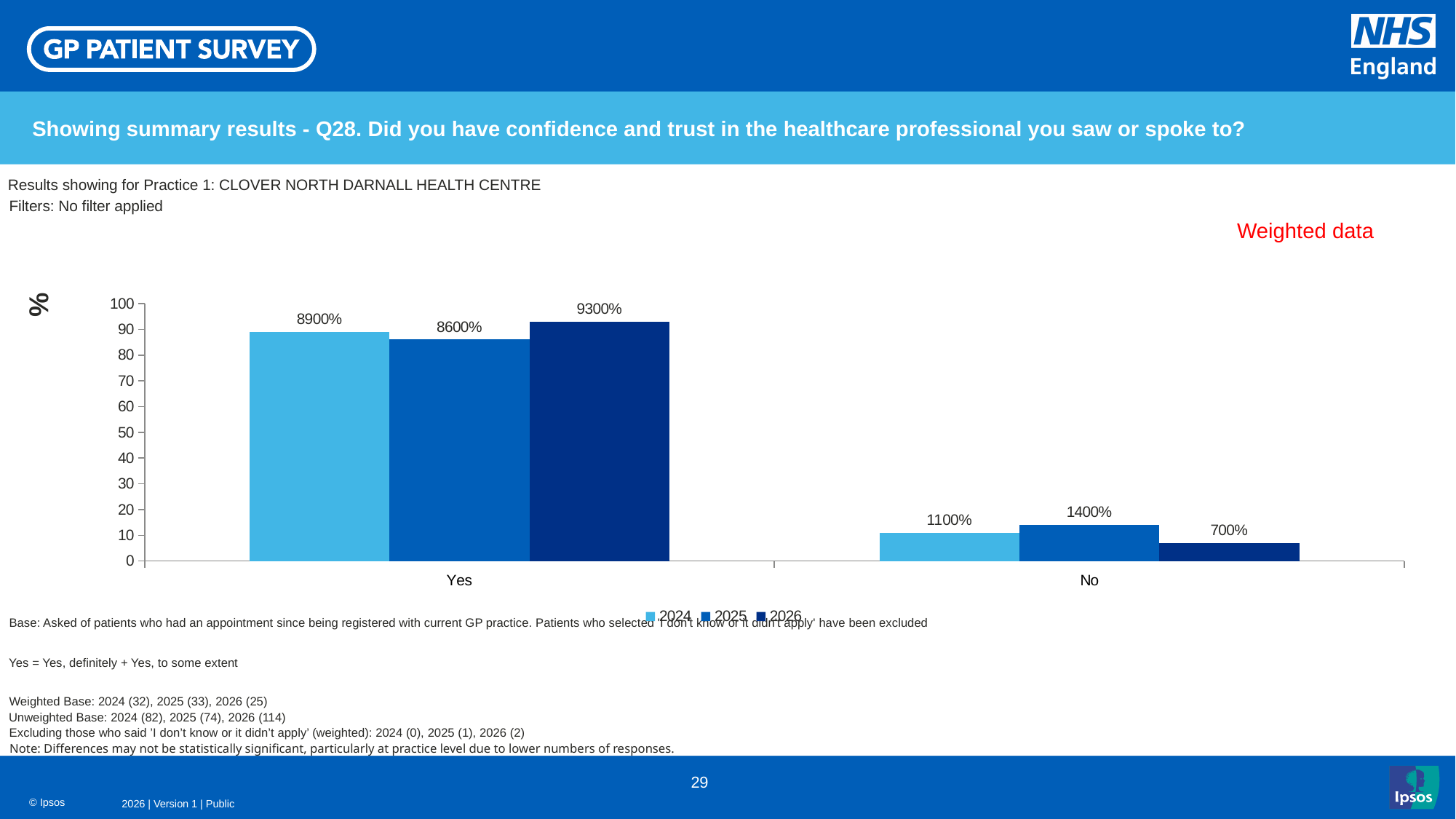
How many categories are shown on the x axis? 2 Which is larger: the 2024 value for No or the 2025 value for No? 2025 How many series does the legend list? 3 What is the value for 2025 in the No category? 1400% What kind of chart is shown on the slide? Bar chart What is the difference between the 2026 and 2025 values in the Yes category? 700% What is the value for 2026 in the Yes category? 9300% What is the label on the vertical axis? % Which year has the lowest value in the No category? 2026 What is the value for 2024 in the Yes category? 8900% Which year has the highest value in the Yes category? 2026 What is the value for 2026 in the No category? 700%